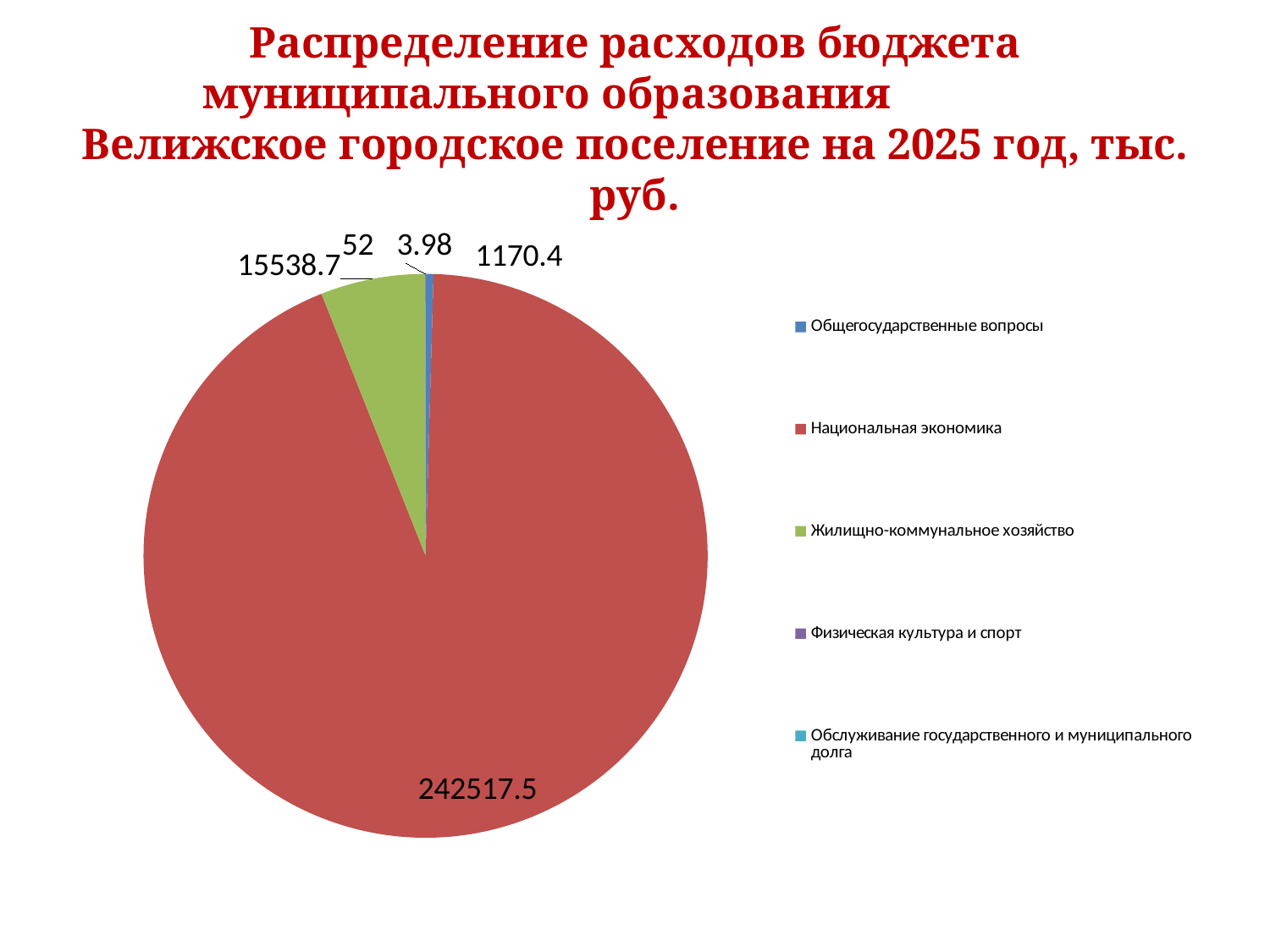
What is the value for Общегосударственные вопросы? 1170.4 How many categories does the legend list? 5 Which category has the smallest value? Обслуживание государственного и муниципального долга What type of chart is shown on the slide? Pie chart What is the value for Национальная экономика? 242517.5 What is the value for Физическая культура и спорт? 52 What colour is the slice for Жилищно-коммунальное хозяйство? Green What is the value for Жилищно-коммунальное хозяйство? 15538.7 Which is larger: Жилищно-коммунальное хозяйство or Общегосударственные вопросы? Жилищно-коммунальное хозяйство What is the value for Обслуживание государственного и муниципального долга? 3.98 What is the difference between the values for Национальная экономика and Жилищно-коммунальное хозяйство? 226978.8 Which category has the largest share of the pie? Национальная экономика